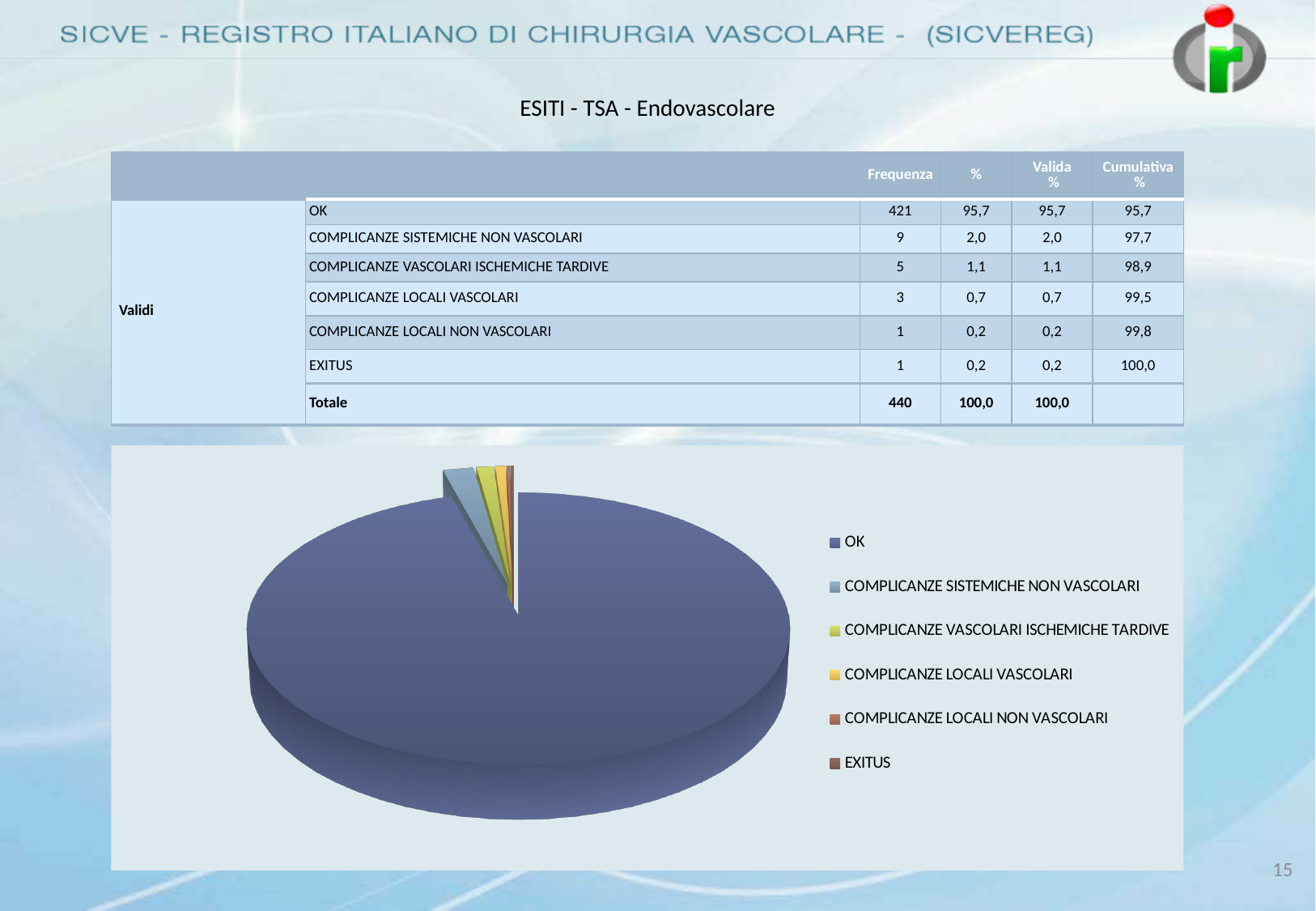
According to the table, what is the Frequenza for COMPLICANZE SISTEMICHE NON VASCOLARI? 9 How many categories does the pie chart's legend list? 6 What is the Totale Frequenza shown in the table? 440 What is the Cumulativa % value for EXITUS in the table? 100,0 What share of the pie does the OK slice represent, according to the table's % column? 95,7 Which category has the largest slice of the pie chart? OK According to the table, what percentage (%) corresponds to COMPLICANZE VASCOLARI ISCHEMICHE TARDIVE? 1,1 Which is larger: the slice for COMPLICANZE SISTEMICHE NON VASCOLARI or the slice for COMPLICANZE LOCALI VASCOLARI? COMPLICANZE SISTEMICHE NON VASCOLARI What kind of chart is shown on the slide? pie chart According to the table, what is the Frequenza for OK? 421 What is the title of the slide above the table and chart? ESITI - TSA - Endovascolare What is the difference in Frequenza between OK and COMPLICANZE SISTEMICHE NON VASCOLARI? 412